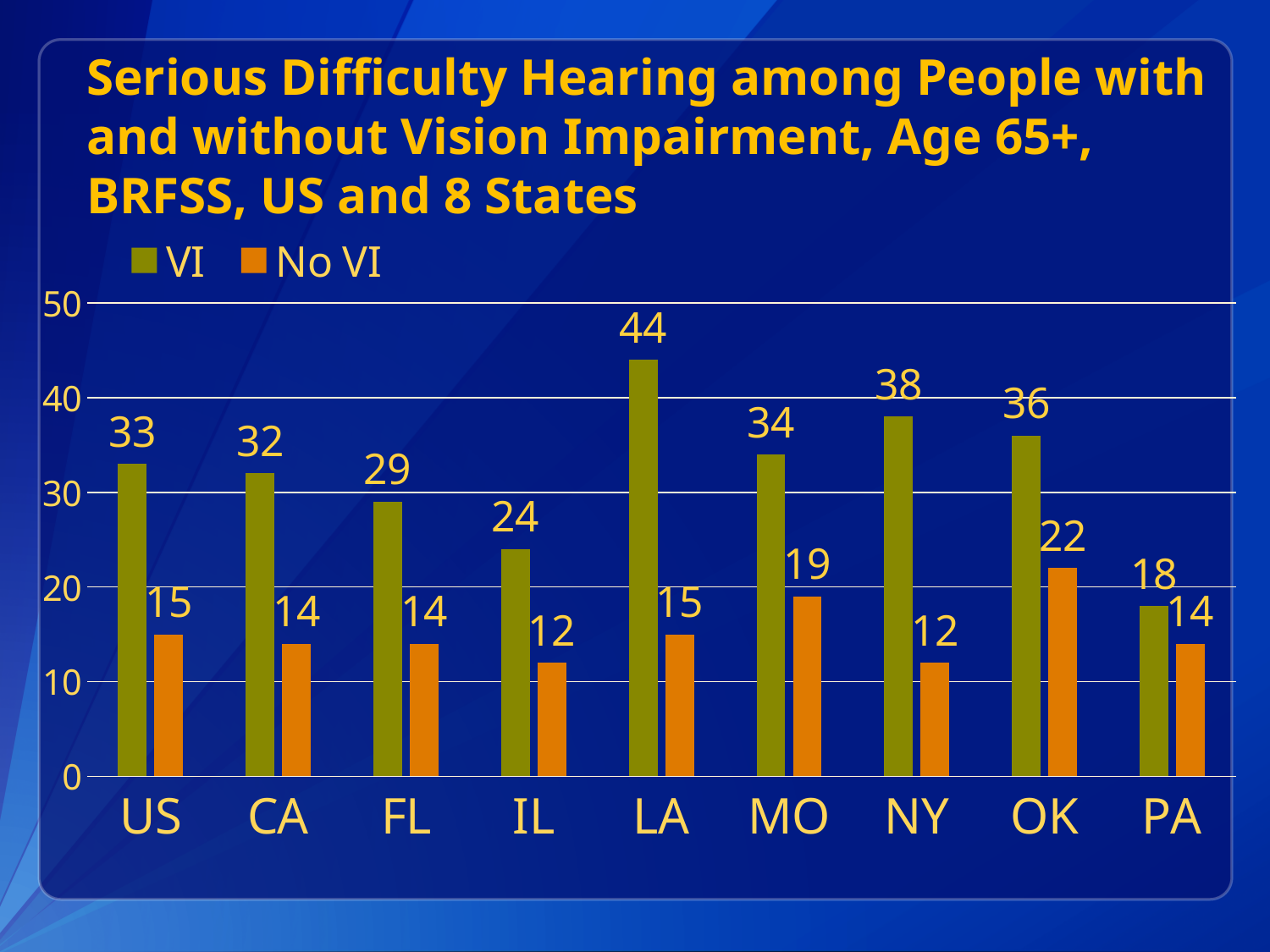
Which is larger, the VI value for MO or the VI value for CA? MO What is the VI value for LA? 44 Which category has the highest VI value? LA What is the No VI value for OK? 22 What colour are the No VI bars? orange How many categories are shown on the x axis? 9 What is the difference between the VI and No VI values for NY? 26 How many series does the legend list? 2 What is the VI value for PA? 18 Which category has the lowest VI value? PA Which category has the highest No VI value? OK What kind of chart is shown on the slide? bar chart